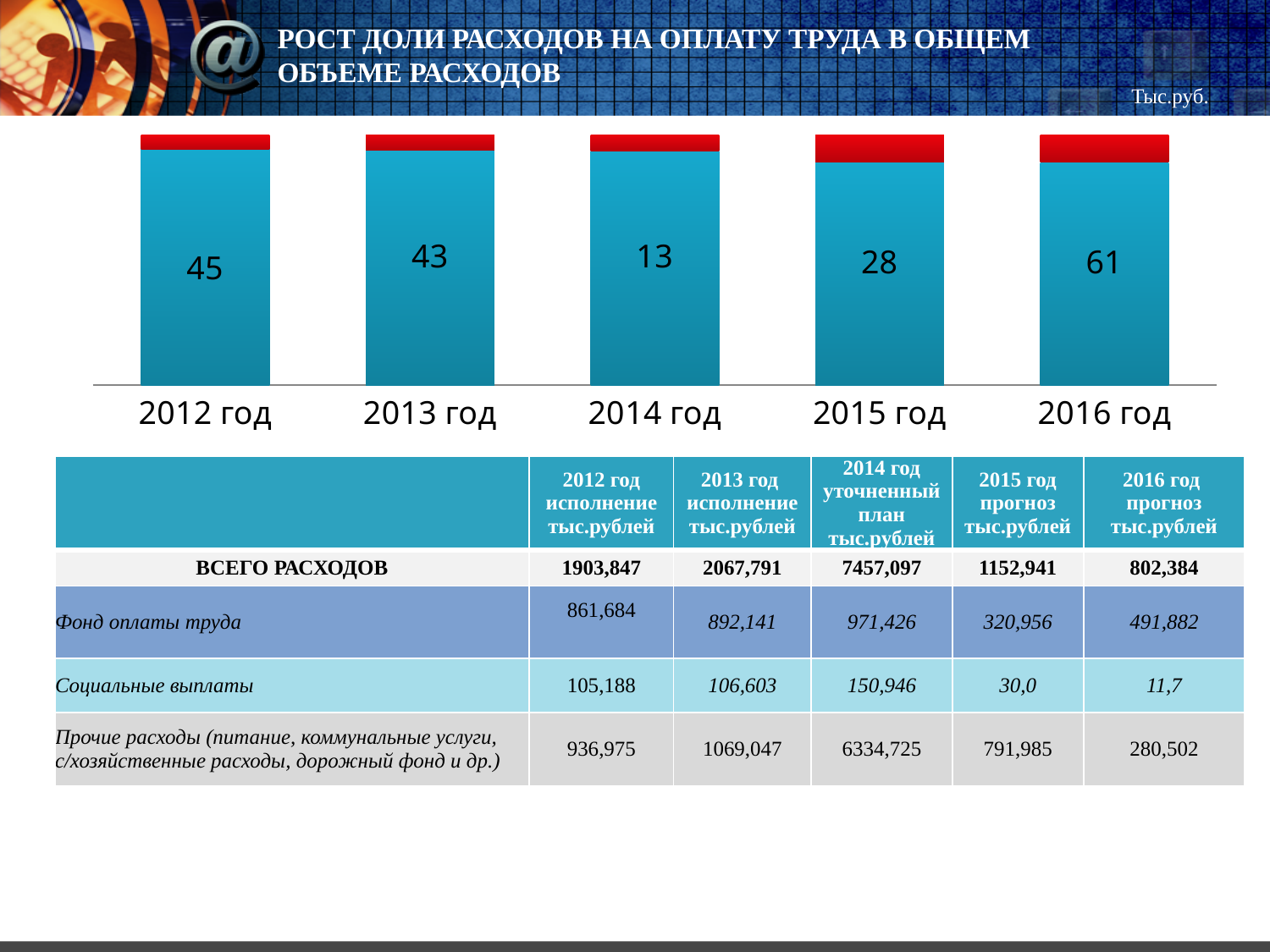
Which year has the lowest printed value on its bar? 2014 год What value is printed on the bar for 2016 год? 61 What is the difference between the printed values for 2012 год and 2013 год? 2 Which year has the highest printed value on its bar? 2016 год What kind of chart is shown on the slide? bar chart Which has the larger printed value, 2013 год or 2015 год? 2013 год What value is printed on the bar for 2014 год? 13 What value is printed on the bar for 2015 год? 28 What colour is the top segment of each bar in the chart? red What is the difference between the printed values for 2016 год and 2014 год? 48 How many years are shown on the x axis of the chart? 5 What value is printed on the bar for 2012 год? 45